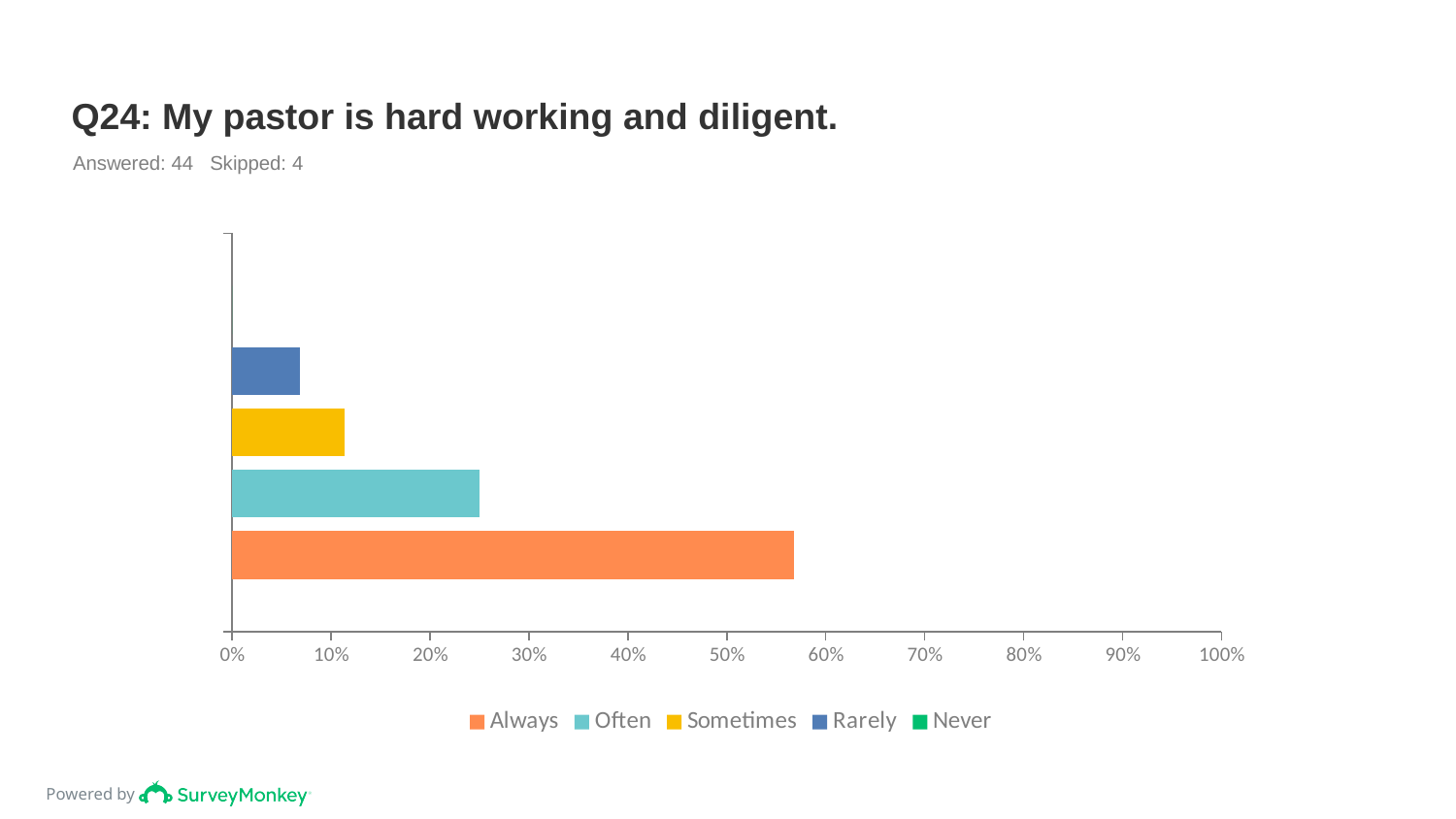
What is the title of the chart? Q24: My pastor is hard working and diligent. What kind of chart is shown on the slide? bar chart Which response category has the lowest value? Never Is the value for Always greater or less than 50%? greater What colour is the bar for Always? orange Is the value for Sometimes greater or less than 20%? less Which response category has the highest value? Always Is the value for Rarely greater or less than 10%? less How many series does the legend list? 5 Which is larger, the value for Rarely or the value for Always? Always Which is larger, the value for Often or the value for Sometimes? Often